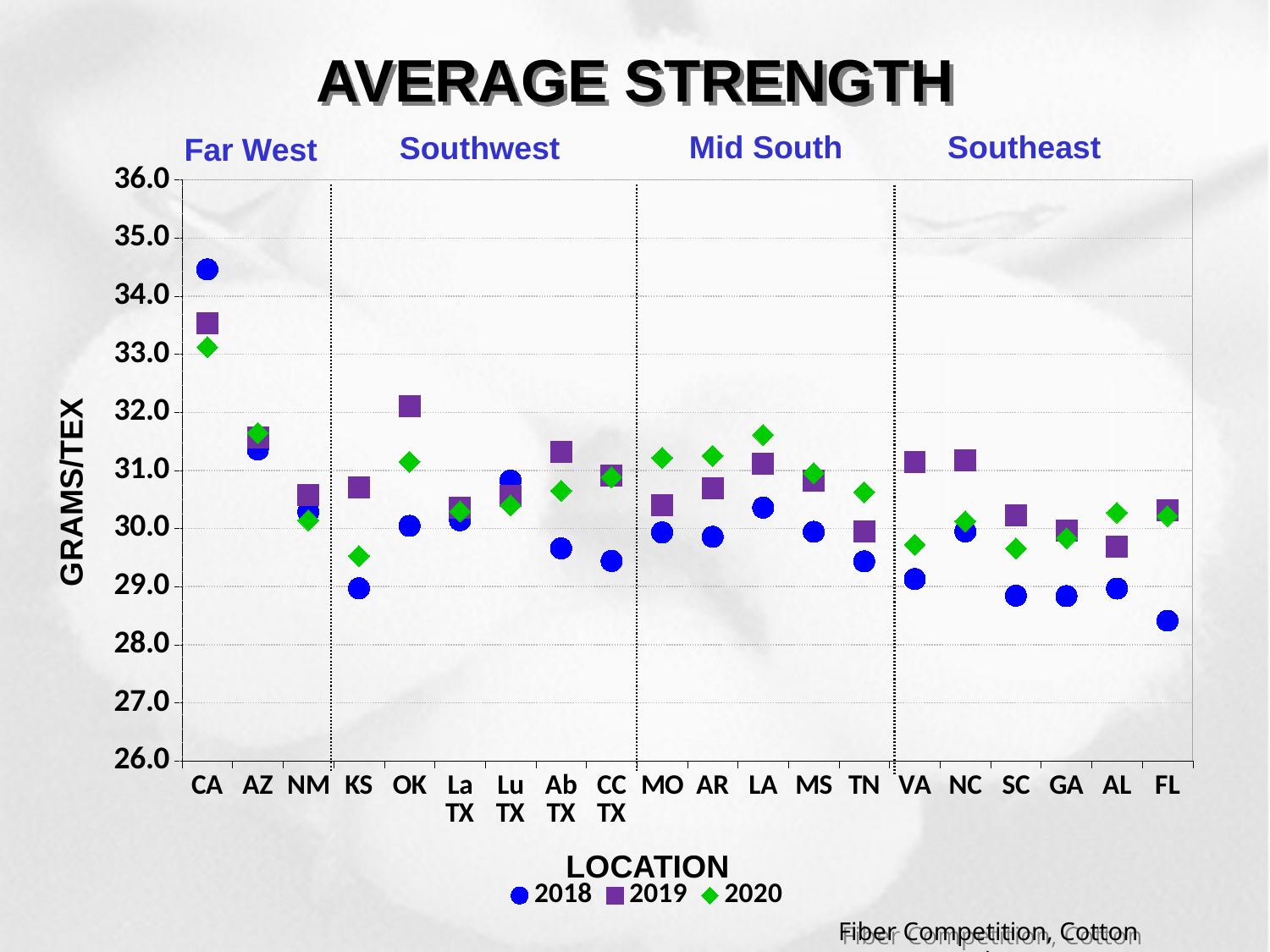
Is the 2018 value for FL greater or less than 29.0? less Which location has the lowest 2018 value? FL Is the 2020 value for KS greater or less than 30.0? less For OK, which is larger, the 2018 value or the 2019 value? 2019 How many series does the legend list? 3 What is the title of the chart? AVERAGE STRENGTH Is the 2018 value for CA greater or less than 34.0? greater What is the label of the y axis? GRAMS/TEX Which location has the highest 2018 value? CA Which location has the highest 2019 value? CA How many locations are plotted along the x axis? 20 What kind of chart is shown on the slide? scatter chart